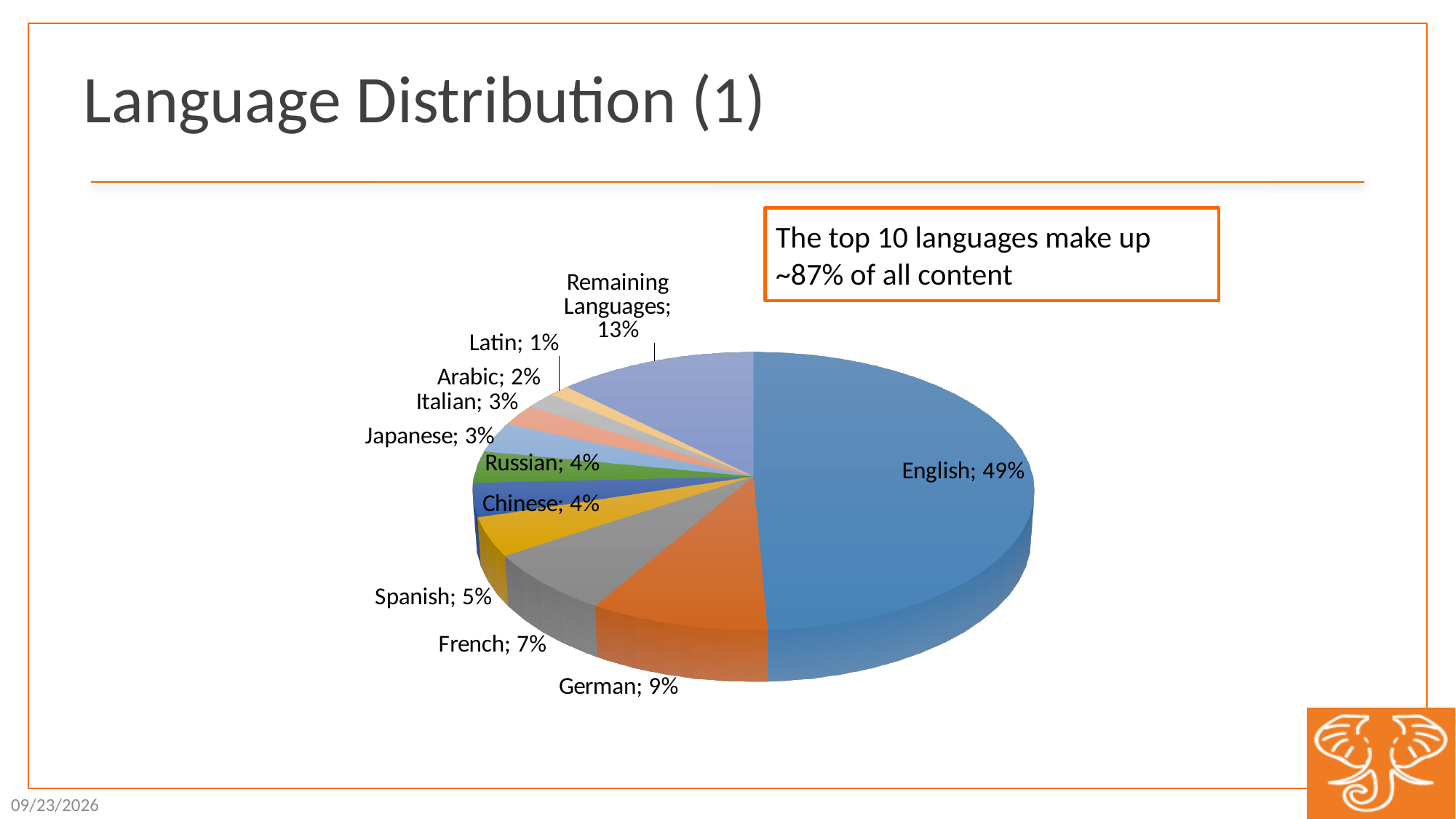
What share of content is French? 7% What share of content is Latin? 1% What share of content is English? 49% What share of content is German? 9% What share of content do the Remaining Languages make up? 13% Which named language has the smallest slice of the pie? Latin What is the title of the slide containing the chart? Language Distribution (1) Which language has the largest slice of the pie? English What is the difference in percentage points between German and French? 2% How many slices does the pie chart have? 11 What kind of chart is shown on the slide? pie chart Which is larger, the share for Spanish or the share for Japanese? Spanish